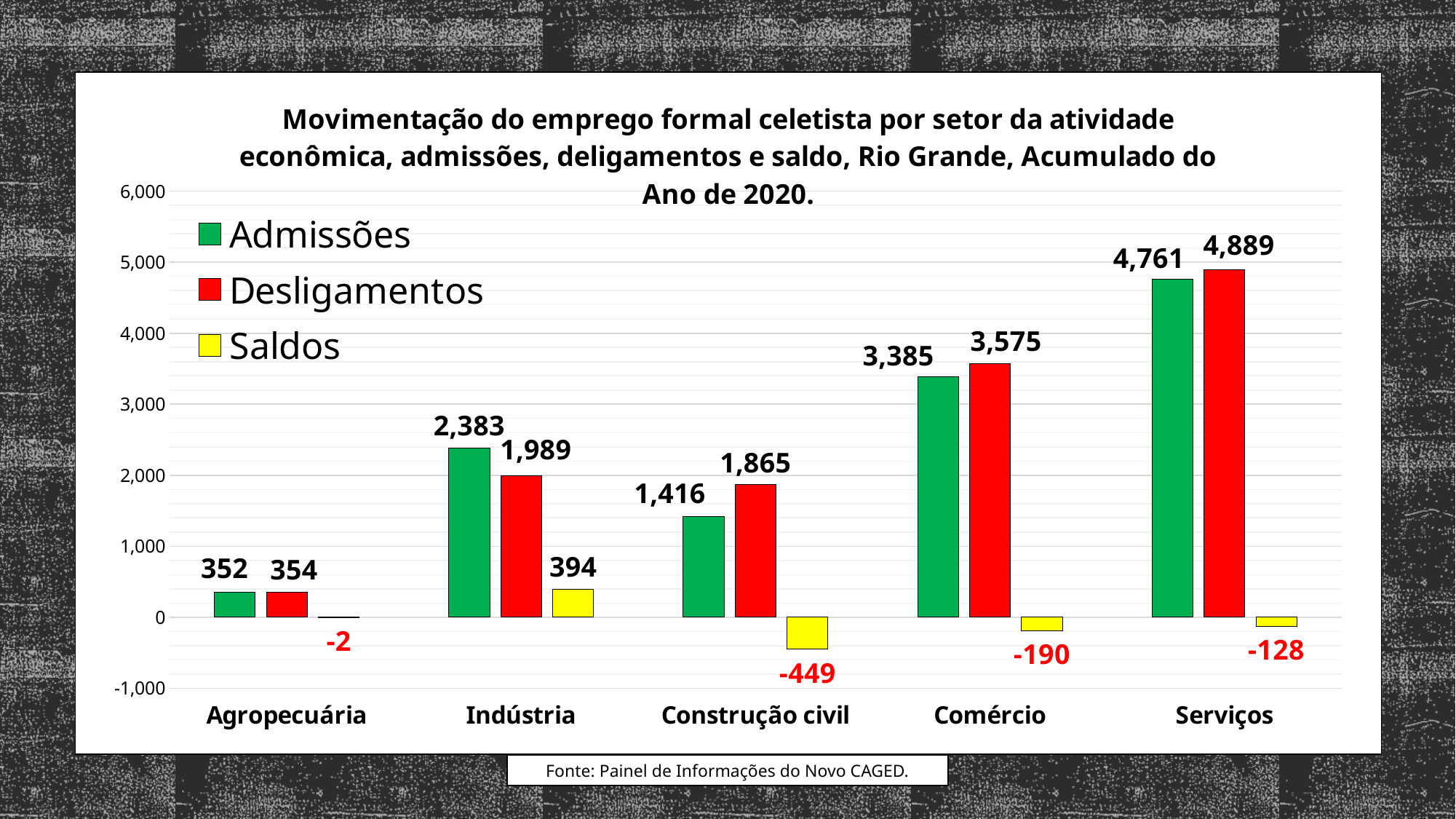
What is the difference between Desligamentos and Admissões for Comércio? 190 Is the Admissões value for Comércio greater or less than 3,000? greater Which colour represents the Saldos series in the legend? Yellow How many sectors are shown on the x axis? 5 What kind of chart is shown on the slide? Bar chart Which sector has the highest Admissões value? Serviços Which sector has the lowest Desligamentos value? Agropecuária What is the Saldos value for Construção civil? -449 What is the Desligamentos value for Serviços? 4,889 What is the Admissões value for Indústria? 2,383 How many series does the legend list? 3 Which is larger for Indústria, Admissões or Desligamentos? Admissões